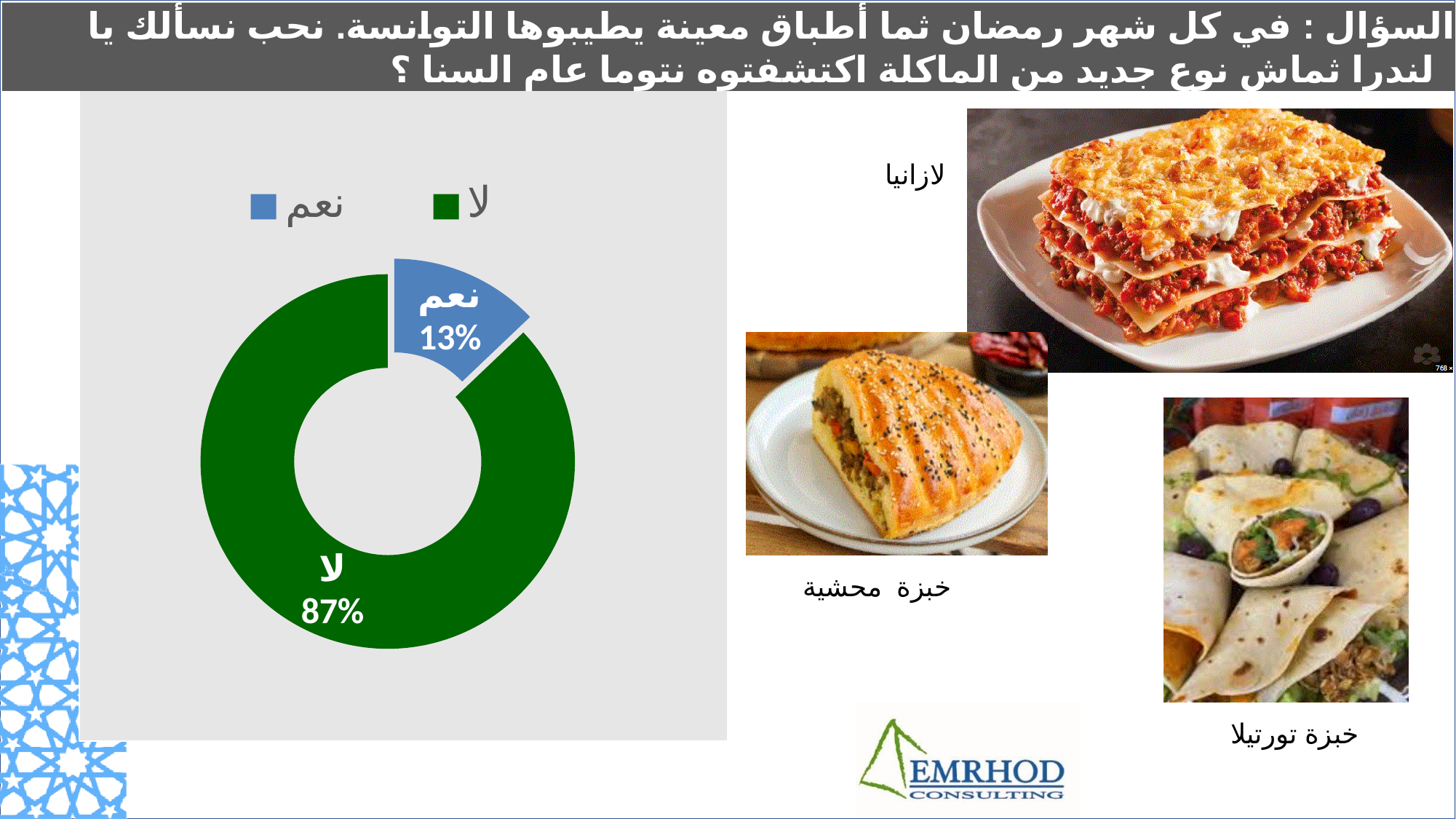
What kind of chart is shown on the slide? Pie chart (doughnut) What is the total of the two slices shown in the chart? 100% What share of the pie does the "نعم" slice represent? 13% Which category has the largest share in the chart? لا What colour is the "نعم" slice? Blue Which is larger, the share for "نعم" or the share for "لا"? لا What colour is the "لا" slice? Green How many categories are shown in the chart? 2 What is the difference in percentage points between the "لا" and "نعم" slices? 74 How many entries does the legend list? 2 Which category has the smallest share in the chart? نعم What share of the pie does the "لا" slice represent? 87%